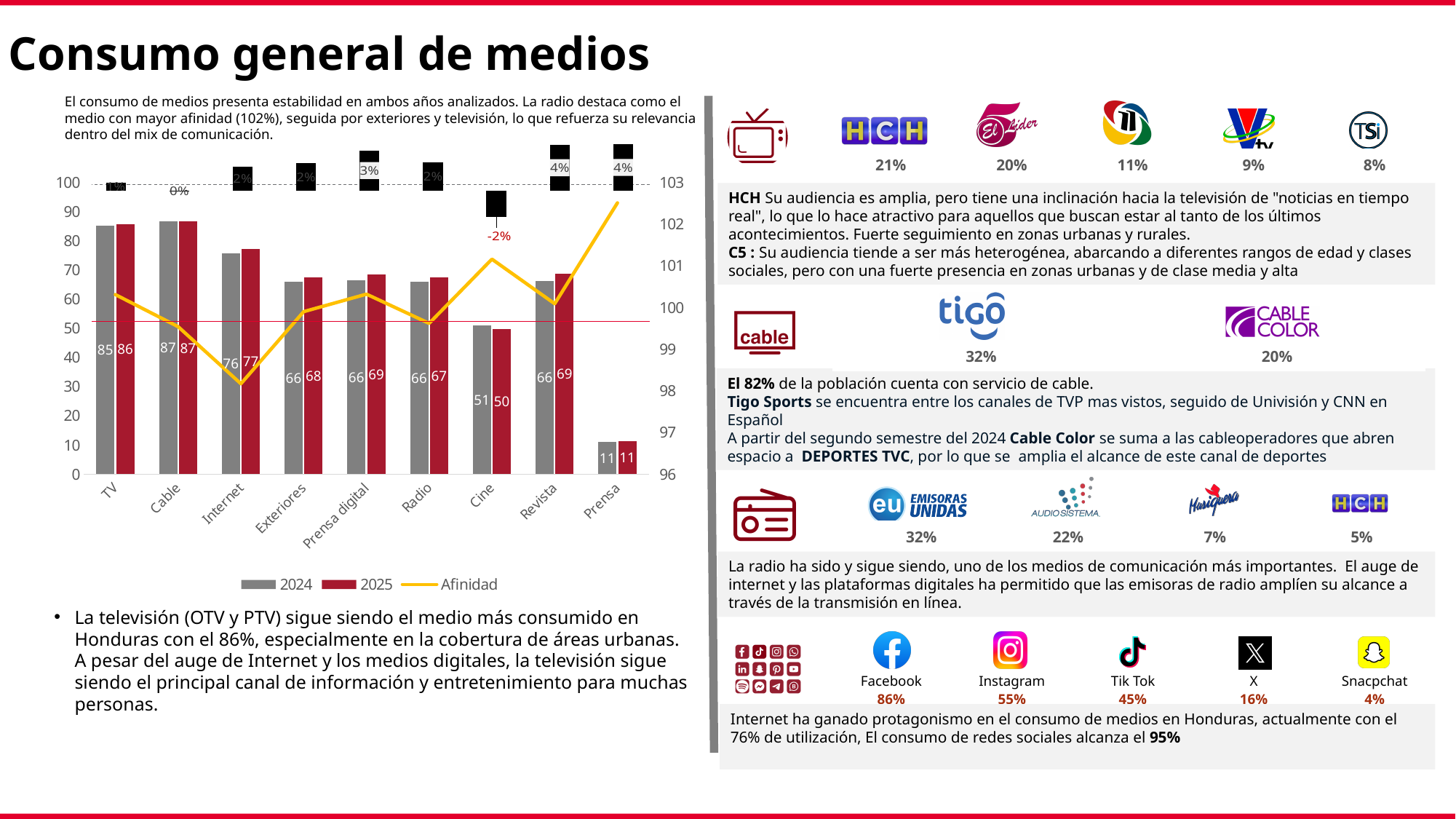
How many series does the chart legend list? 3 Which series in the chart is drawn as a yellow line? Afinidad What is the 2025 value for Prensa digital in the chart? 69 How many media categories are shown on the x axis of the chart? 9 Which is larger for Cine: the 2024 value or the 2025 value? 2024 Is the Afinidad value for Prensa greater or less than 102? greater Which category has the lowest 2024 value in the chart? Prensa What kind of chart is shown on the slide? Combined bar and line chart What is the 2025 value for TV in the chart? 86 What is the difference between the 2025 and 2024 values for Revista? 3 Which category has the highest 2025 value in the chart? Cable What is the 2024 value for Cine in the chart? 51